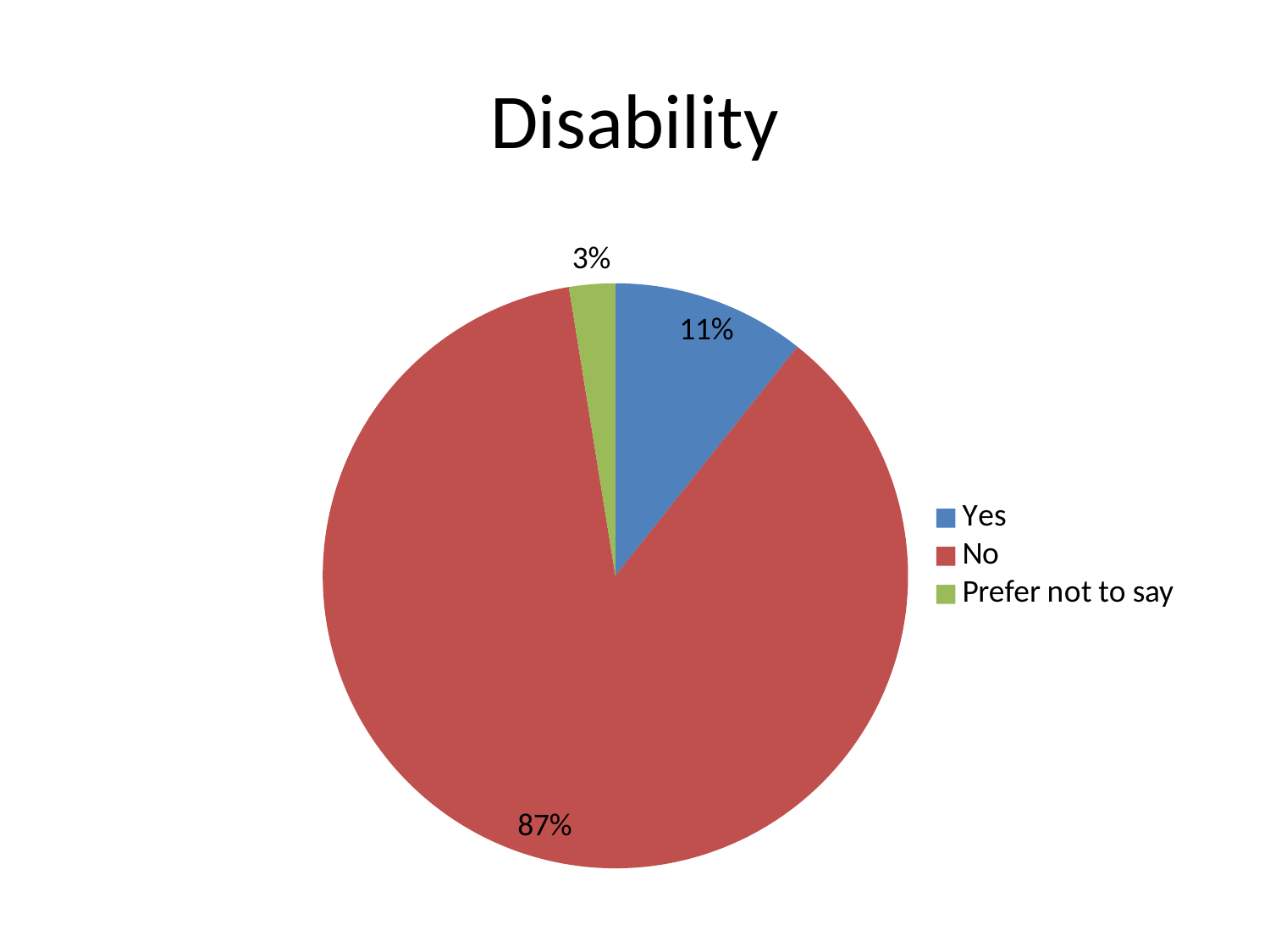
Which is larger, the 'Yes' slice or the 'Prefer not to say' slice? Yes What is the title of the chart? Disability What is the difference in percentage points between the 'Yes' slice and the 'Prefer not to say' slice? 8 Which category has the largest share of the pie? No What is the difference in percentage points between the 'No' slice and the 'Yes' slice? 76 What colour is the 'No' slice? red What percentage of the pie is the 'Prefer not to say' slice? 3% What percentage of the pie is the 'No' slice? 87% How many categories does the legend list? 3 What kind of chart is shown on the slide? pie chart What percentage of the pie is the 'Yes' slice? 11% Which category has the smallest share of the pie? Prefer not to say